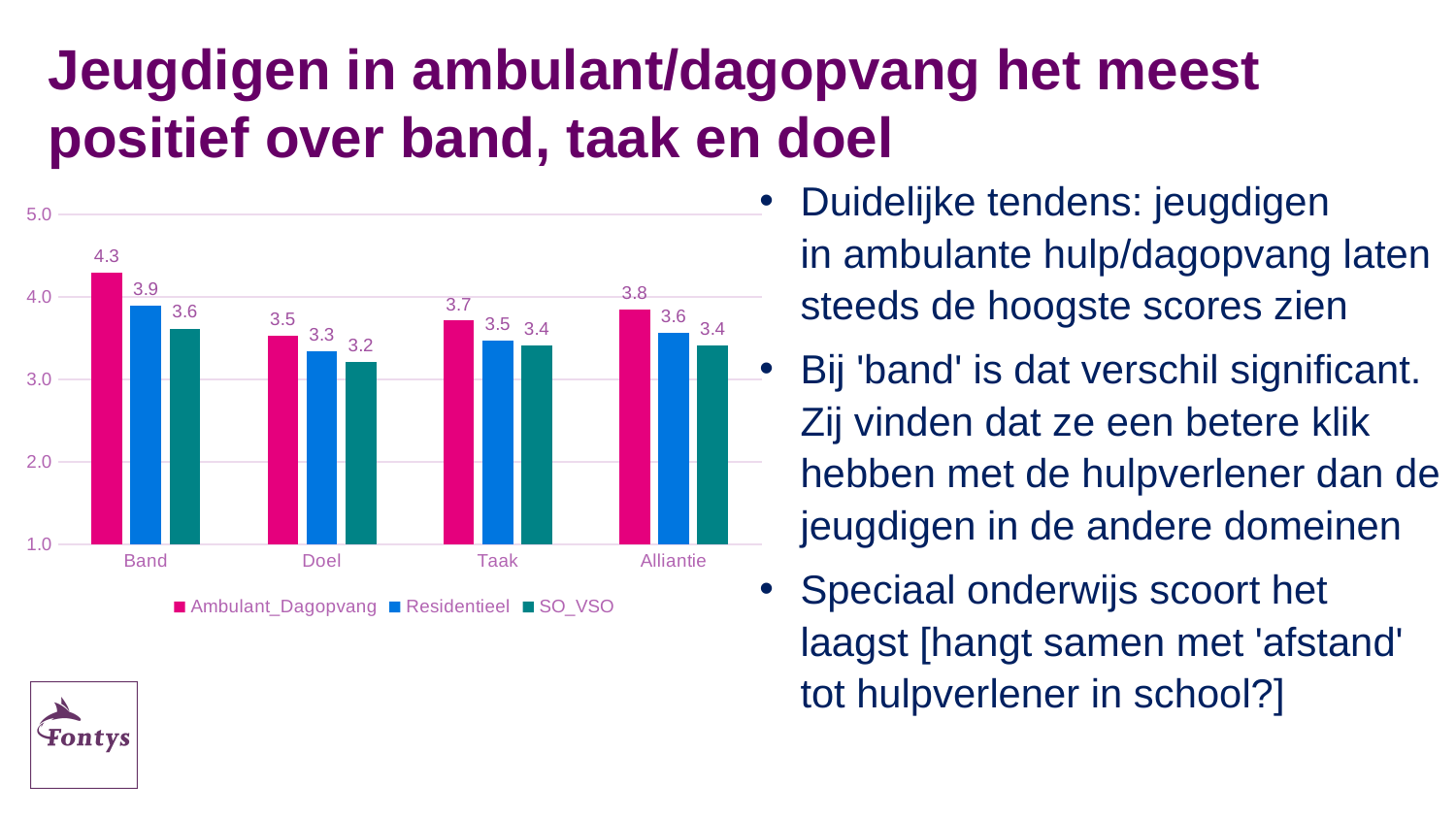
How many series does the legend list? 3 Which series is shown in pink in the legend? Ambulant_Dagopvang Which category has the highest value for Ambulant_Dagopvang? Band Which is larger: the Residentieel value for Taak or the Residentieel value for Alliantie? Alliantie How many categories are shown on the x axis? 4 Which category has the lowest value for SO_VSO? Doel What is the value for Ambulant_Dagopvang in the Band category? 4.3 What is the difference between the Ambulant_Dagopvang and SO_VSO values in the Band category? 0.7 What kind of chart is shown on the slide? Bar chart Is the value for Ambulant_Dagopvang in the Band category greater or less than 4.0? greater What is the value for Residentieel in the Alliantie category? 3.6 What is the value for SO_VSO in the Doel category? 3.2